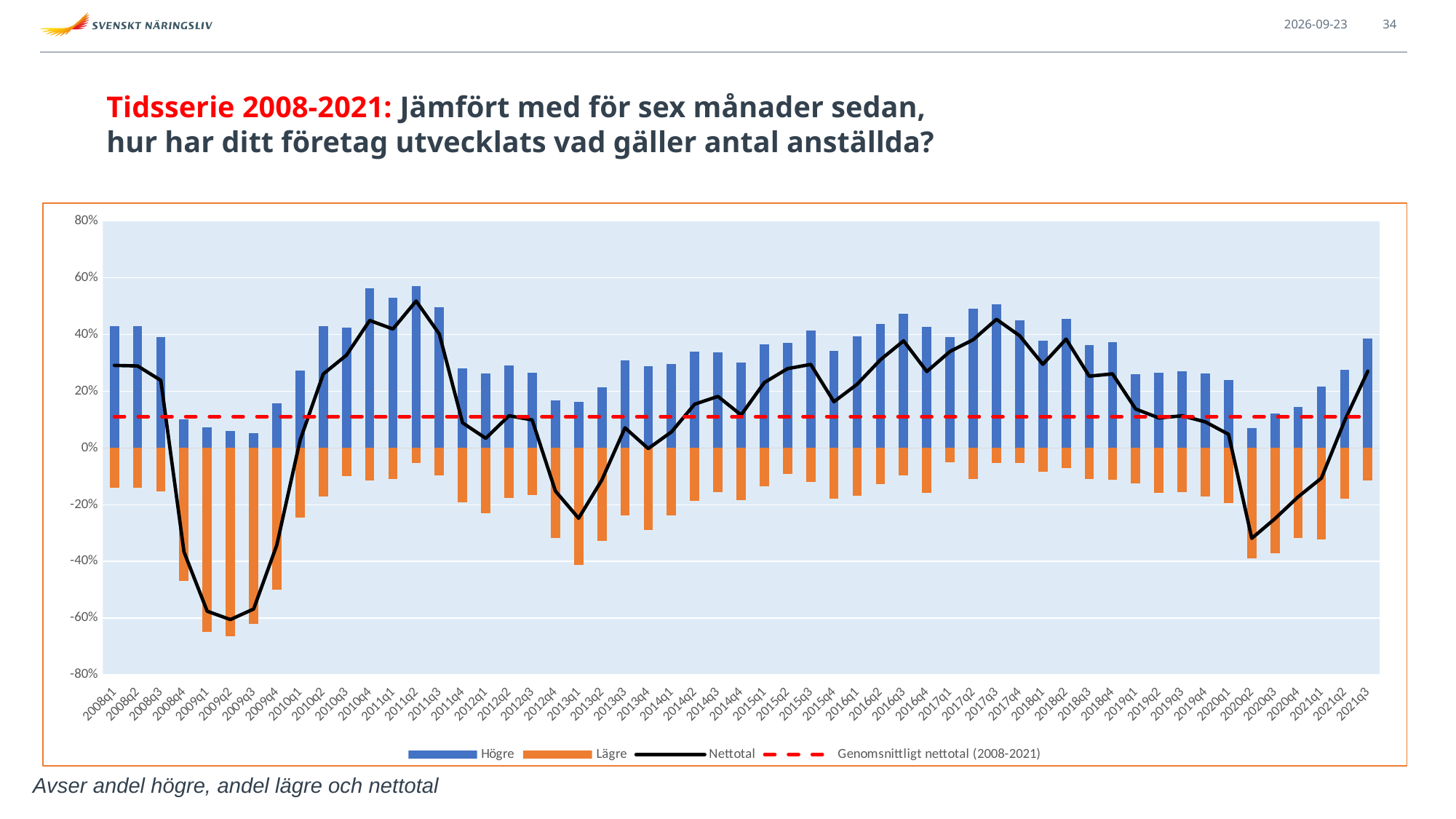
Does the Nettotal line rise or fall from 2020q2 to 2021q3? rise How many quarters are shown on the x axis, from 2008q1 to 2021q3? 55 Which is larger, the Nettotal value for 2017q3 or for 2020q2? 2017q3 What kind of chart is shown on the slide? bar chart with lines Is the Nettotal value for 2017q3 greater or less than 40%? greater Is the Lägre value for 2009q2 greater or less than -60%? less Is the Högre value for 2010q4 greater or less than 40%? greater How many series does the legend list? 4 Which is larger, the Högre value for 2010q4 or for 2008q4? 2010q4 What does the red dashed line in the chart represent? Genomsnittligt nettotal (2008-2021)